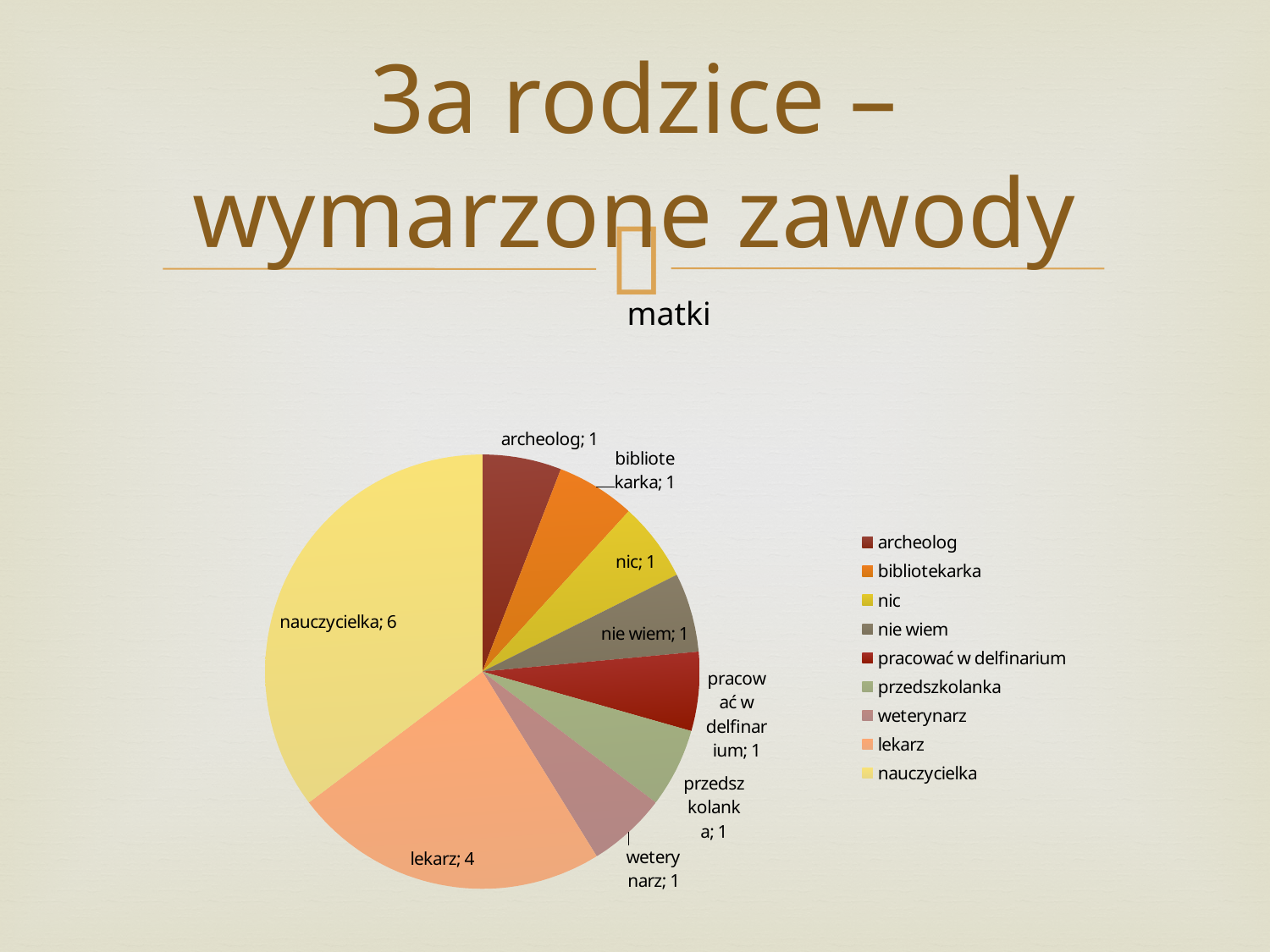
What is the value for archeolog? 1 Which category has the largest slice of the pie? nauczycielka What is the value for nauczycielka? 6 What kind of chart is shown on the slide? pie chart How many entries does the legend list? 9 What is the value for weterynarz? 1 Which is larger, the value for lekarz or the value for nic? lekarz How many categories does the pie chart have? 9 What is the value for lekarz? 4 What is the title of the chart? matki What is the difference between the values for nauczycielka and lekarz? 2 What is the total of all the values in the pie chart? 17